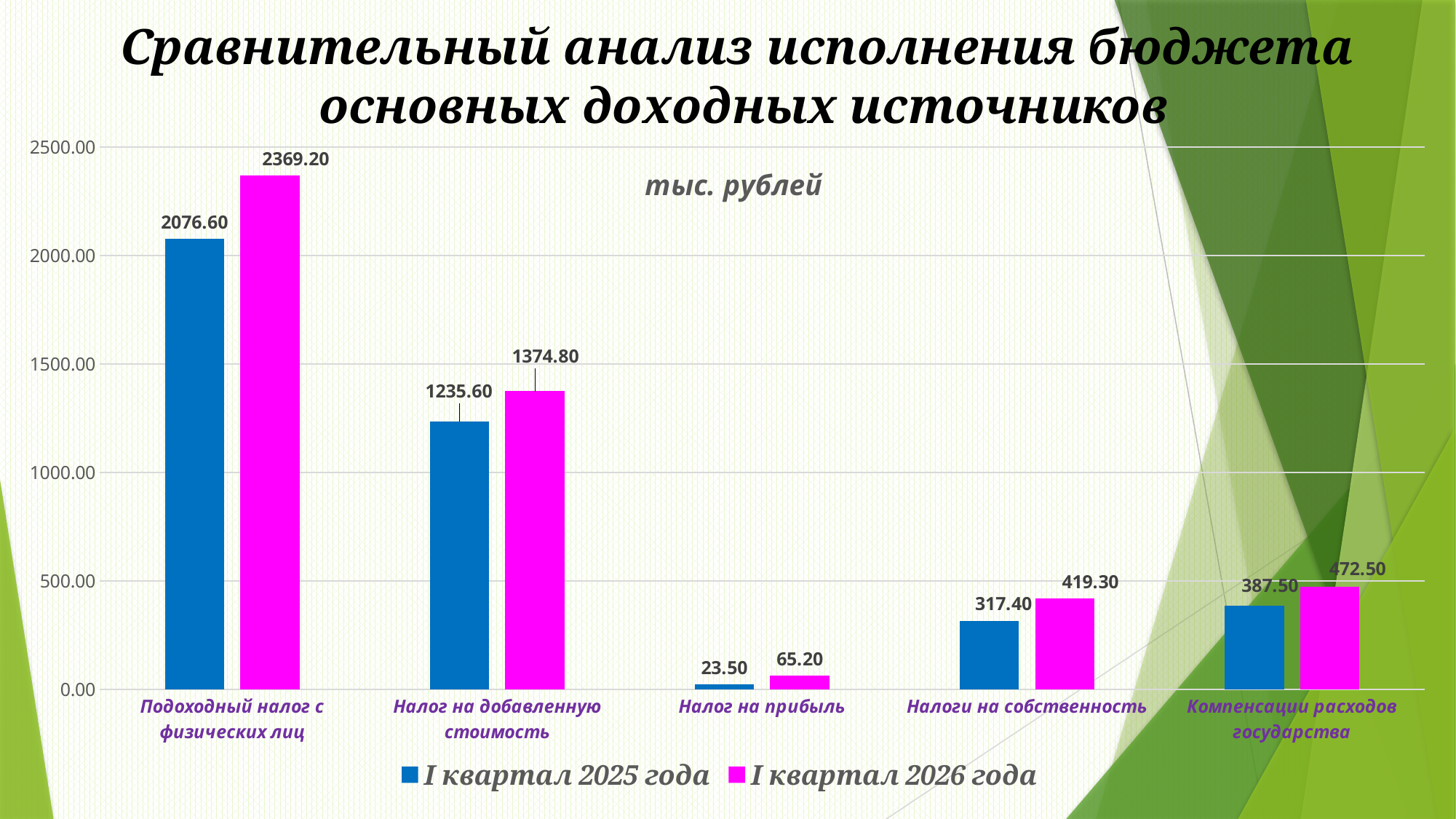
What is the value for Налоги на собственность in the I квартал 2026 года series? 419.30 How many series does the legend list? 2 What unit label is shown above the chart? тыс. рублей What is the value for Подоходный налог с физических лиц in the I квартал 2026 года series? 2369.20 What is the difference between the I квартал 2026 года and I квартал 2025 года values for Налог на добавленную стоимость? 139.20 Which category has the highest value in the I квартал 2025 года series? Подоходный налог с физических лиц What is the value for Налог на прибыль in the I квартал 2025 года series? 23.50 How many categories are shown on the x axis? 5 What kind of chart is shown on the slide? bar chart Which is larger for Компенсации расходов государства: the I квартал 2025 года value or the I квартал 2026 года value? I квартал 2026 года Which category has the lowest value in the I квартал 2026 года series? Налог на прибыль Is the I квартал 2025 года value for Налоги на собственность greater or less than 500.00? less